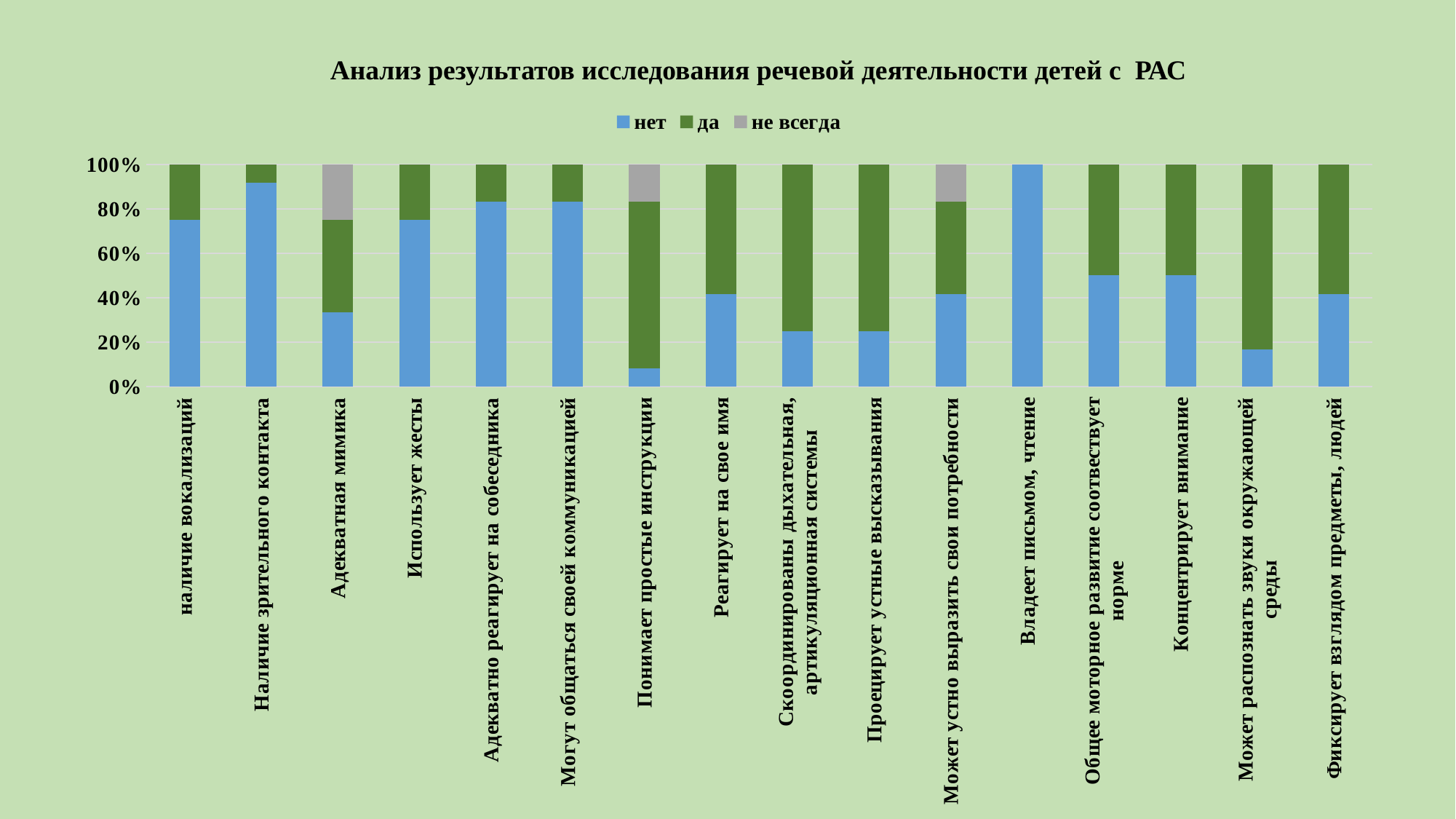
What is the title of the chart? Анализ результатов исследования речевой деятельности детей с РАС Is the 'нет' value for 'Наличие зрительного контакта' greater or less than 80%? greater How many series does the legend list? 3 How many categories are shown along the x axis? 16 Which category has the lowest value for the 'нет' series? Понимает простые инструкции Which category has the highest value for the 'нет' series? Владеет письмом, чтение Which has the larger 'нет' value: 'Наличие зрительного контакта' or 'Реагирует на свое имя'? Наличие зрительного контакта Is the 'нет' value for 'наличие вокализаций' greater or less than 60%? greater What is the value of the 'нет' series for 'Владеет письмом, чтение'? 100% Is the 'нет' value for 'Понимает простые инструкции' greater or less than 20%? less What kind of chart is shown on the slide? Stacked bar chart Which series is shown in grey in the legend? не всегда